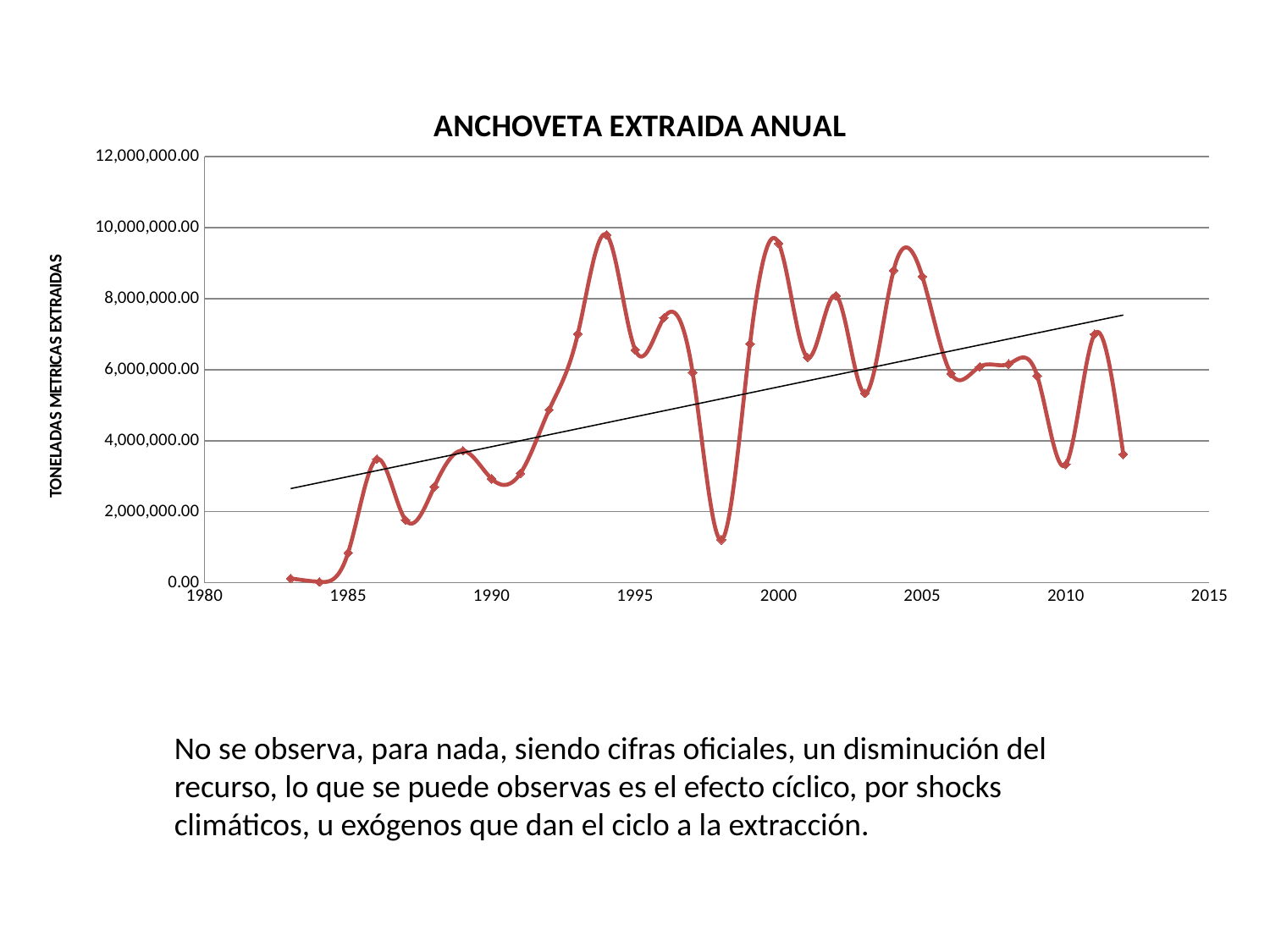
What kind of chart is shown on the slide? line chart Which year has the lowest value on the chart? 1984 Which year has the larger value, 1998 or 1999? 1999 What is the title of the chart? ANCHOVETA EXTRAIDA ANUAL Is the value for 1994 greater or less than 8,000,000.00? greater What is the label of the vertical axis? TONELADAS METRICAS EXTRAIDAS Is the value for 2004 greater or less than 8,000,000.00? greater Is the value for 1998 greater or less than 2,000,000.00? less Which year has the larger value, 2000 or 2001? 2000 Does the straight black trend line rise or fall from left to right? rises